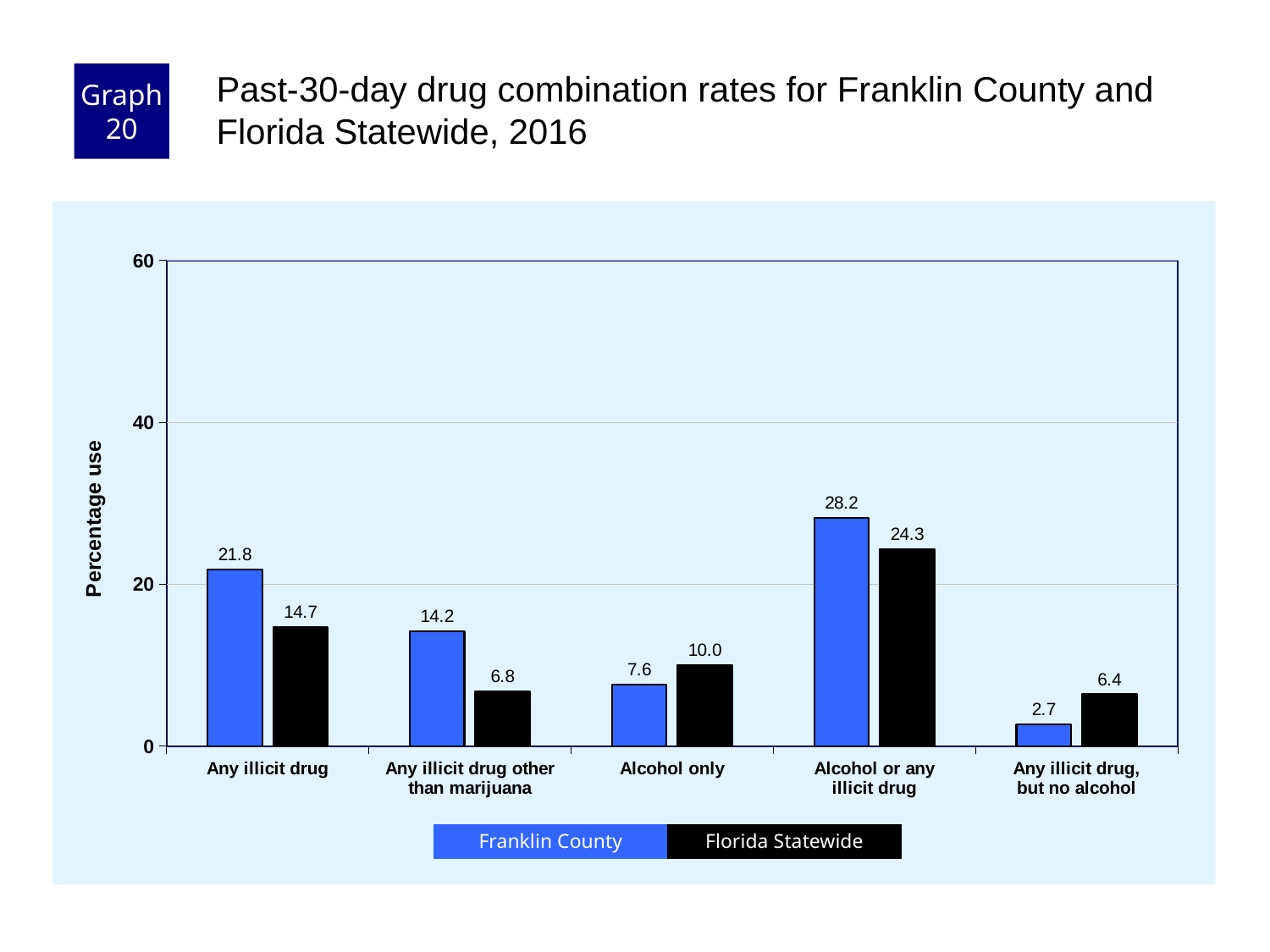
What is the Franklin County value for Any illicit drug? 21.8 What is the Franklin County value for Any illicit drug, but no alcohol? 2.7 How many categories are shown on the x axis? 5 Is the Florida Statewide value for Alcohol or any illicit drug greater or less than 20? greater Which category has the highest Franklin County value? Alcohol or any illicit drug Which category has the lowest Florida Statewide value? Any illicit drug, but no alcohol What is the difference between the Franklin County and Florida Statewide values for Any illicit drug other than marijuana? 7.4 What is the label of the y axis? Percentage use How many series does the legend list? 2 What kind of chart is shown on the slide? bar chart What is the Florida Statewide value for Alcohol only? 10.0 Which is larger for Alcohol only: Franklin County or Florida Statewide? Florida Statewide